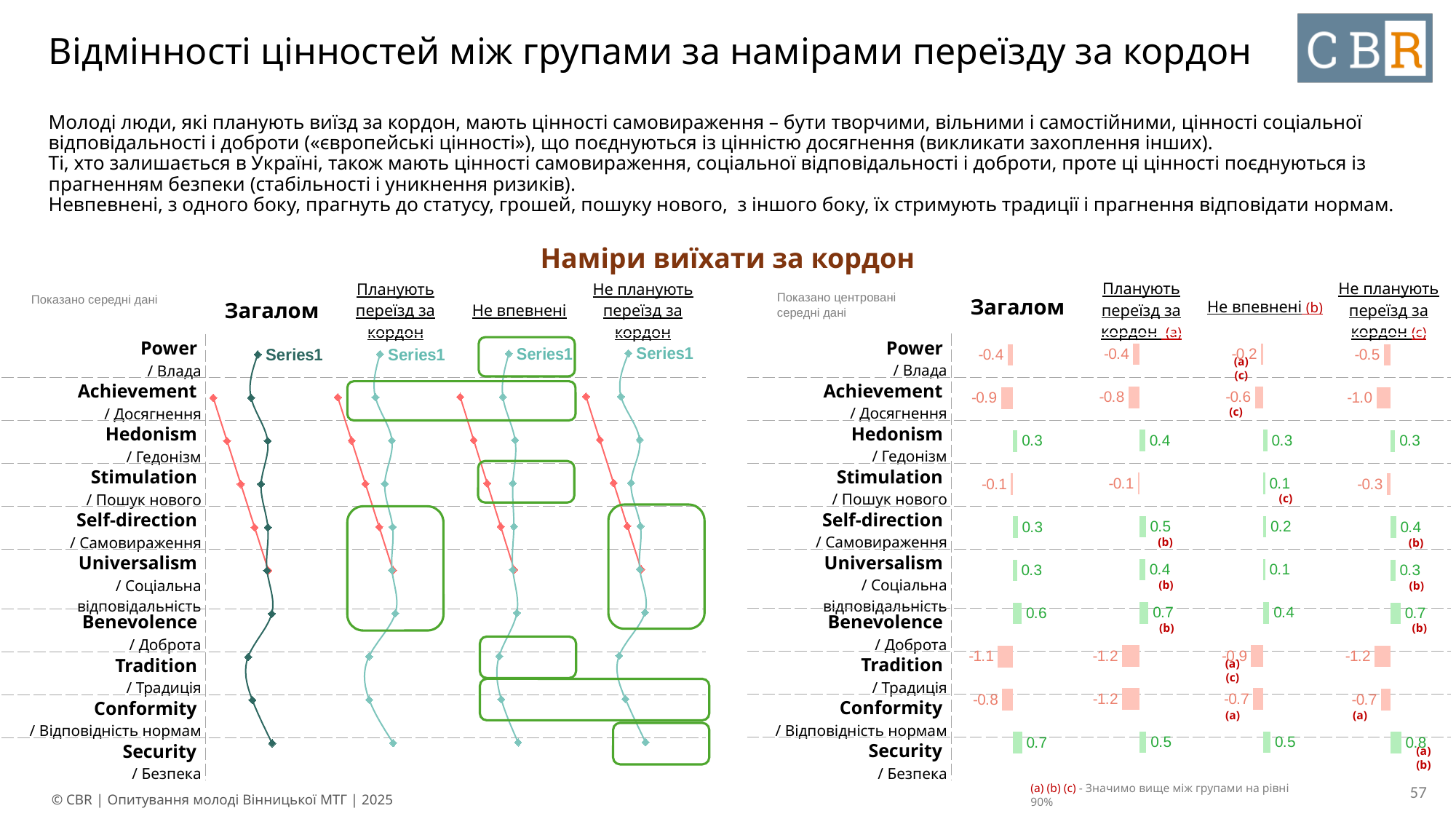
In the right-hand bar chart for the 'Загалом' group, which value category has the lowest value? Tradition / Традиція What type of chart is used on the left-hand side of the slide under 'Загалом'? Line chart In the right-hand bar chart for the 'Загалом' group, what is the value for Security / Безпека? 0.7 In the right-hand bar chart for the 'Не планують переїзд за кордон' group, which value category has the highest value? Security / Безпека In the right-hand bar chart for the 'Не планують переїзд за кордон' group, what is the value for Achievement / Досягнення? -1.0 How many value categories are listed on the vertical axis of the charts? 10 What is the title shown above the charts on the slide? Наміри виїхати за кордон In the right-hand bar chart for the 'Загалом' group, which value category has the highest value? Security / Безпека In the right-hand bar chart for the 'Планують переїзд за кордон' group, what is the value for Conformity / Відповідність нормам? -1.2 In the right-hand bar chart for the 'Не впевнені' group, what is the value for Stimulation / Пошук нового? 0.1 In the right-hand bar charts, which group has the larger Benevolence / Доброта value: 'Планують переїзд за кордон' or 'Не впевнені'? Планують переїзд за кордон In the right-hand bar charts, what is the difference between the Self-direction value for 'Планують переїзд за кордон' (0.5) and for 'Не впевнені' (0.2)? 0.3